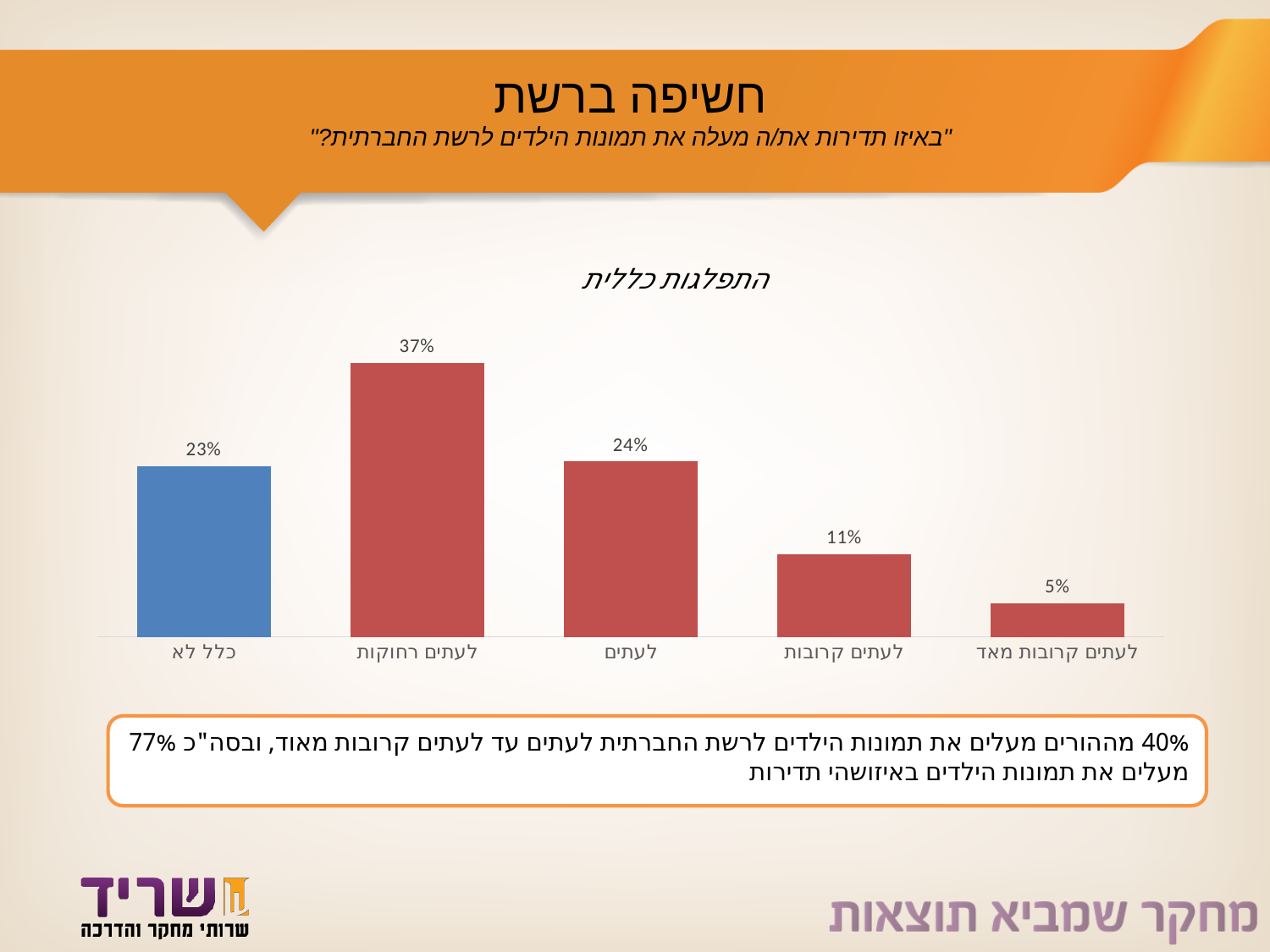
What kind of chart is shown on the slide? bar chart What is the value for the category "לעתים קרובות"? 11% What is the difference between the values for "לעתים קרובות" and "לעתים קרובות מאד"? 6% What is the difference between the values for "לעתים רחוקות" and "לעתים"? 13% What is the value for the category "לעתים קרובות מאד"? 5% Which category has the highest value? לעתים רחוקות Which is larger, the value for "כלל לא" or the value for "לעתים קרובות"? כלל לא Which category has the lowest value? לעתים קרובות מאד How many categories are shown in the chart? 5 What is the value for the category "כלל לא"? 23% What is the value for the category "לעתים רחוקות"? 37% What is the title of the chart? התפלגות כללית